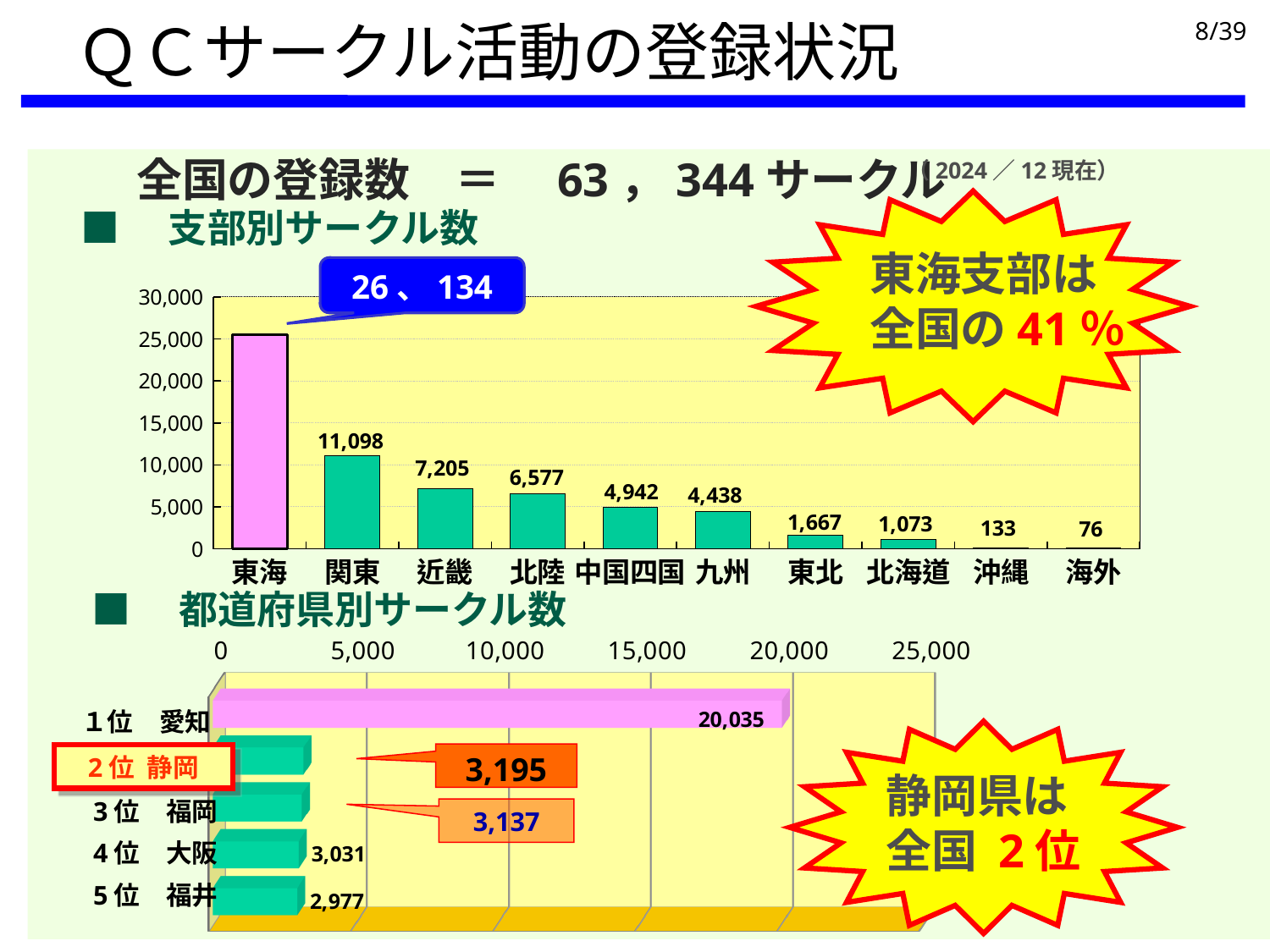
In the 支部別サークル数 chart, which category has the lowest value? 海外 In the 支部別サークル数 chart, do the values rise or fall from left to right along the x axis? fall In the 都道府県別サークル数 chart, what is the difference between 静岡 and 福岡? 58 In the 支部別サークル数 chart, how many branches are shown on the x axis? 10 In the 支部別サークル数 chart, what is the value for 関東? 11,098 In the 支部別サークル数 chart, which branch has the highest number of circles? 東海 In the 支部別サークル数 chart, what is the value for 北陸? 6,577 What kind of chart is the 都道府県別サークル数 chart? bar chart In the 都道府県別サークル数 chart, what is the value for 愛知? 20,035 In the 都道府県別サークル数 chart, how many prefectures are listed? 5 In the 支部別サークル数 chart, which is larger, 北陸 or 中国四国? 北陸 In the 支部別サークル数 chart, what is the difference between 関東 and 近畿? 3,893